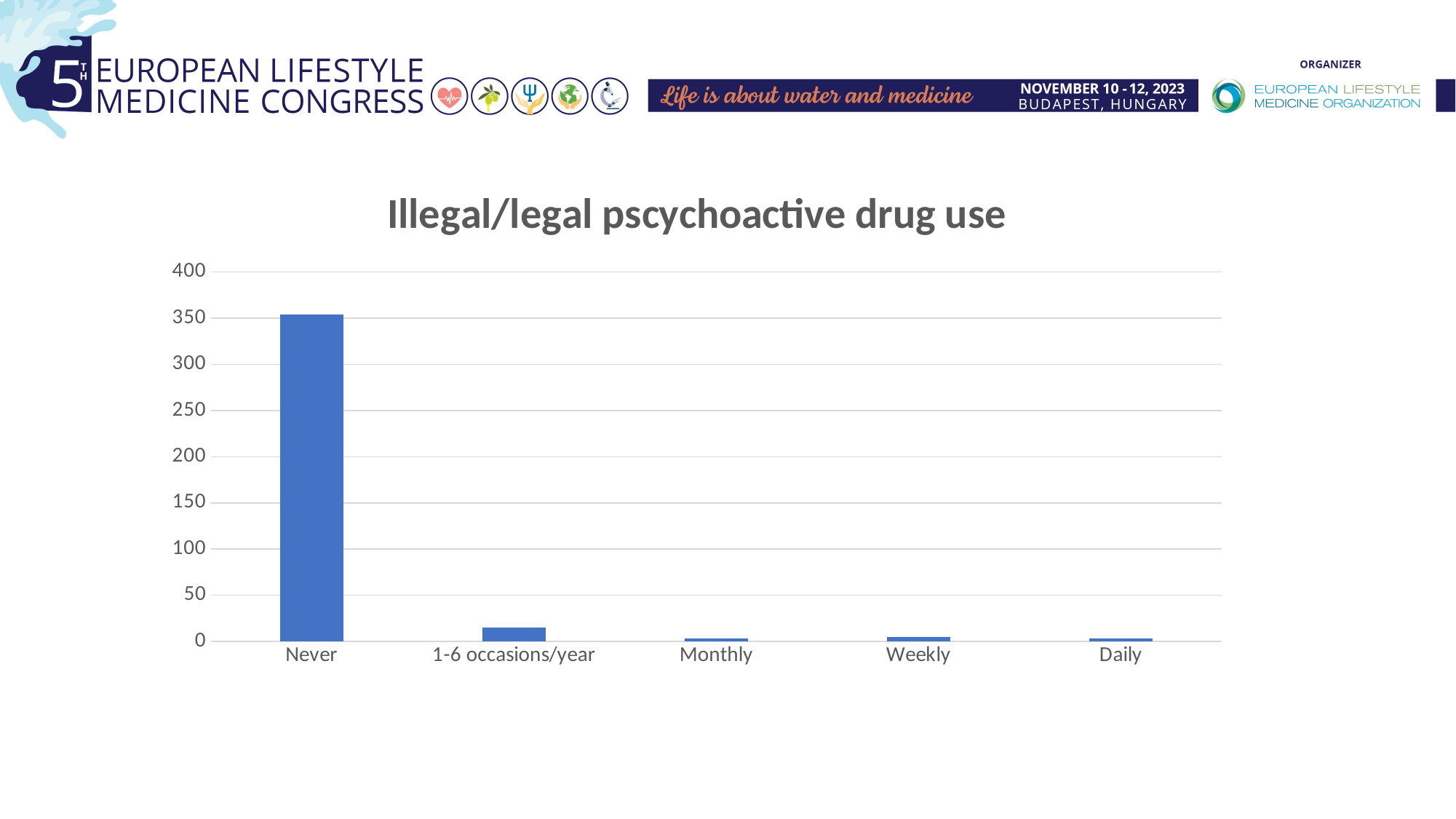
How many categories are shown on the x axis of the chart? 5 What kind of chart is shown on the slide? bar chart Is the value for Weekly greater or less than 50? less What is the highest value shown on the y axis of the chart? 400 Which is larger, the value for 1-6 occasions/year or the value for Daily? 1-6 occasions/year Does the value rise or fall from Never to 1-6 occasions/year? fall Is the value for Never greater or less than 400? less Is the value for Never greater or less than 300? greater Which category has the highest value in the chart? Never What is the title of the chart? Illegal/legal pscychoactive drug use Which is larger, the value for Never or the value for 1-6 occasions/year? Never